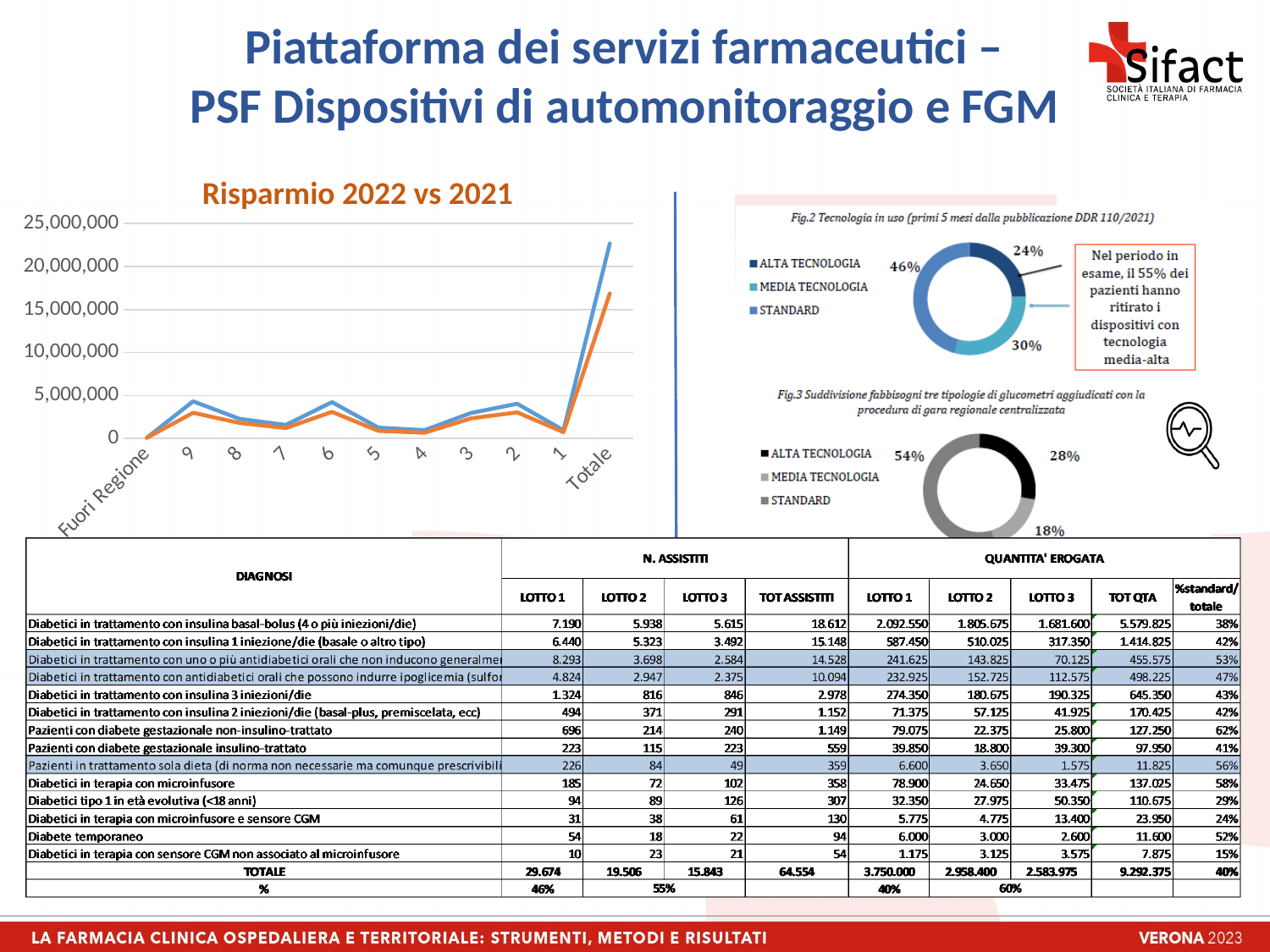
How many entries does the legend of the Fig.2 'Tecnologia in uso' chart list? 3 In the Fig.2 'Tecnologia in uso' chart, which category has the largest share? STANDARD What kind of chart is the 'Risparmio 2022 vs 2021' chart? line chart In the Fig.3 chart on glucometer types, what is the difference between the STANDARD share and the ALTA TECNOLOGIA share? 26% In the Fig.3 chart on glucometer types, what share is MEDIA TECNOLOGIA? 18% In the Fig.2 'Tecnologia in uso' chart, what share is ALTA TECNOLOGIA? 24% How many categories are shown on the x axis of the 'Risparmio 2022 vs 2021' chart? 11 In the Fig.3 chart on glucometer types, which category has the smallest share? MEDIA TECNOLOGIA In the Fig.2 'Tecnologia in uso' chart, what share is STANDARD? 46% In the 'Risparmio 2022 vs 2021' chart, is the value of the blue line for Totale greater or less than 20,000,000? greater In the 'Risparmio 2022 vs 2021' chart, is the value of the orange line for Totale greater or less than 15,000,000? greater In the 'Risparmio 2022 vs 2021' chart, which category has the highest values? Totale